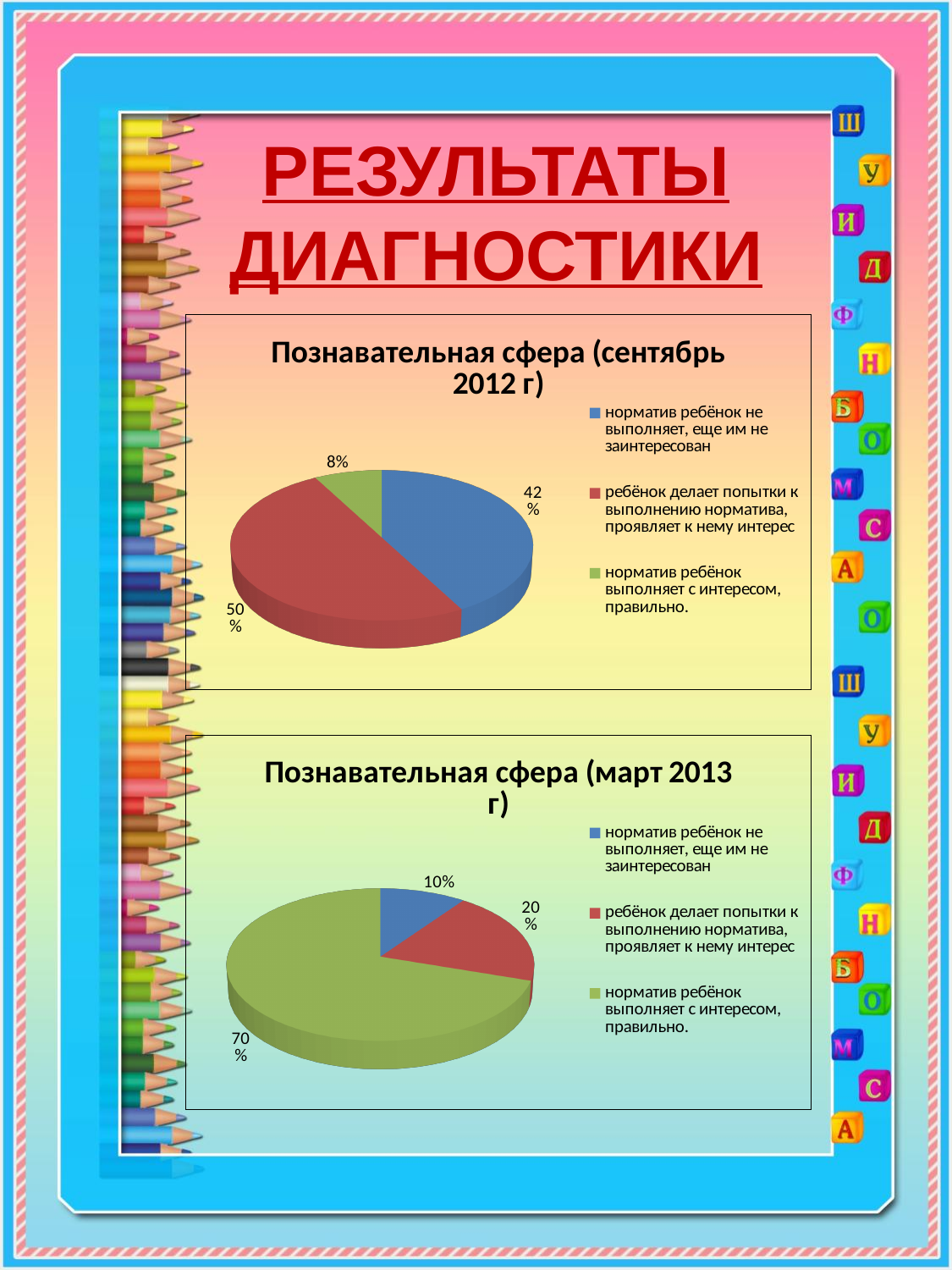
In the chart titled "Познавательная сфера (сентябрь 2012 г)", what share is shown for "норматив ребёнок выполняет с интересом, правильно"? 8% In the chart titled "Познавательная сфера (март 2013 г)", what share is shown for "норматив ребёнок не выполняет, еще им не заинтересован"? 10% In the chart titled "Познавательная сфера (март 2013 г)", which category has the largest slice? норматив ребёнок выполняет с интересом, правильно. What type of chart is the top chart on the slide? pie chart In the chart titled "Познавательная сфера (сентябрь 2012 г)", which is larger: the share for "норматив ребёнок не выполняет" or the share for "ребёнок делает попытки к выполнению норматива"? ребёнок делает попытки к выполнению норматива, проявляет к нему интерес In the chart titled "Познавательная сфера (сентябрь 2012 г)", what colour is the slice for "норматив ребёнок выполняет с интересом, правильно"? green How many categories does the legend of the chart titled "Познавательная сфера (март 2013 г)" list? 3 In the chart titled "Познавательная сфера (сентябрь 2012 г)", what share is shown for "ребёнок делает попытки к выполнению норматива, проявляет к нему интерес"? 50% In the chart titled "Познавательная сфера (сентябрь 2012 г)", which category has the smallest slice? норматив ребёнок выполняет с интересом, правильно. In the chart titled "Познавательная сфера (март 2013 г)", what share is shown for "норматив ребёнок выполняет с интересом, правильно"? 70% In the chart titled "Познавательная сфера (март 2013 г)", what is the difference between the shares for "ребёнок делает попытки к выполнению норматива" and "норматив ребёнок не выполняет"? 10% In the chart titled "Познавательная сфера (сентябрь 2012 г)", what share is shown for "норматив ребёнок не выполняет, еще им не заинтересован"? 42%